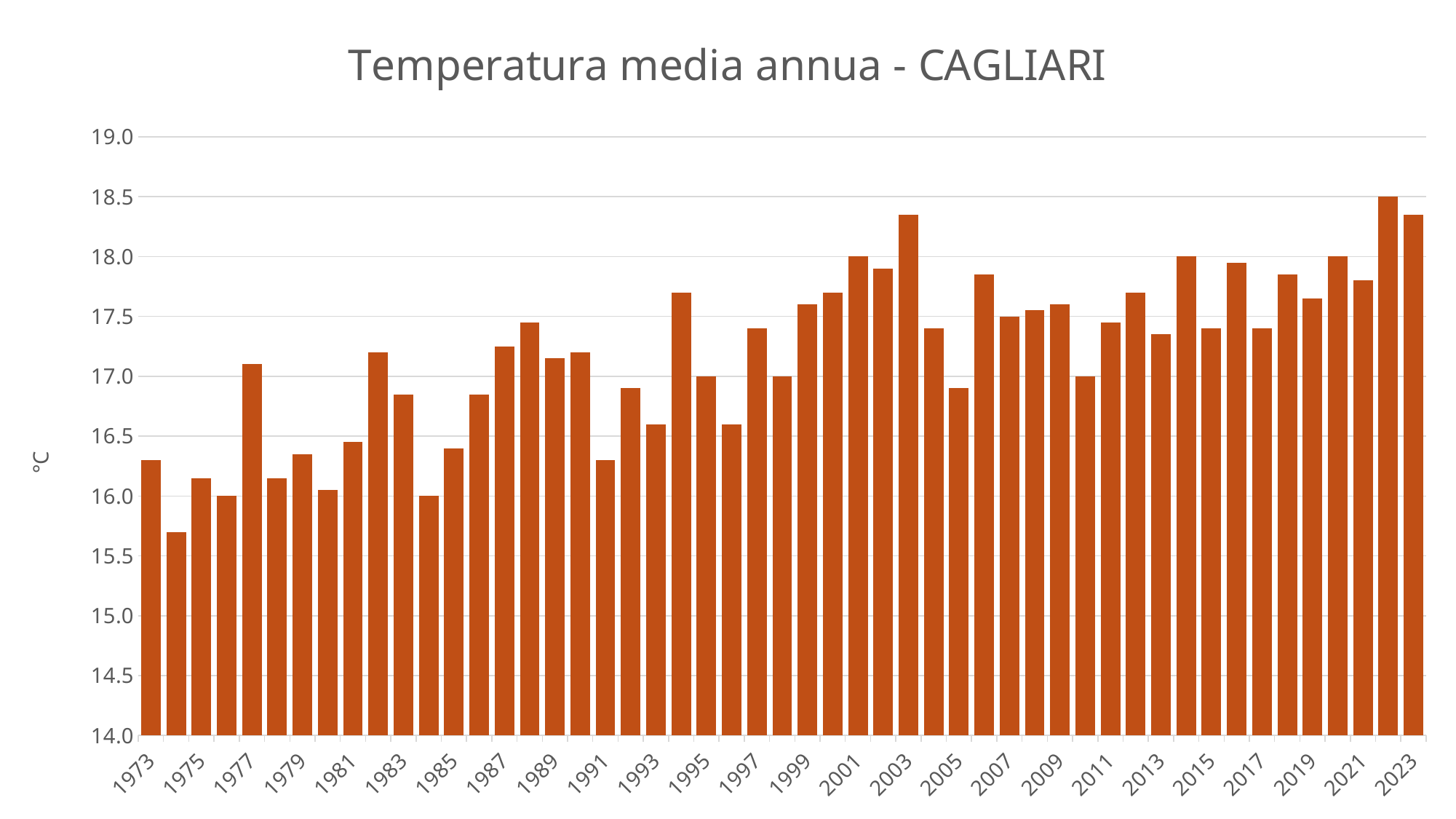
Is the value for 1974 greater or less than 16.0? less How many years (bars) are plotted in the chart? 51 Which year has the higher average temperature, 1993 or 1994? 1994 What is the average temperature for 2022? 18.5 What kind of chart is shown on the slide? bar chart Which year has the highest average temperature? 2022 Which year has the lowest average temperature? 1974 Overall, do the average temperatures rise or fall from 1973 to 2023? rise What unit is shown on the y axis of the chart? °C What is the title of the chart? Temperatura media annua - CAGLIARI Is the value for 1991 greater or less than 16.5? less Is the value for 2003 greater or less than 18.0? greater